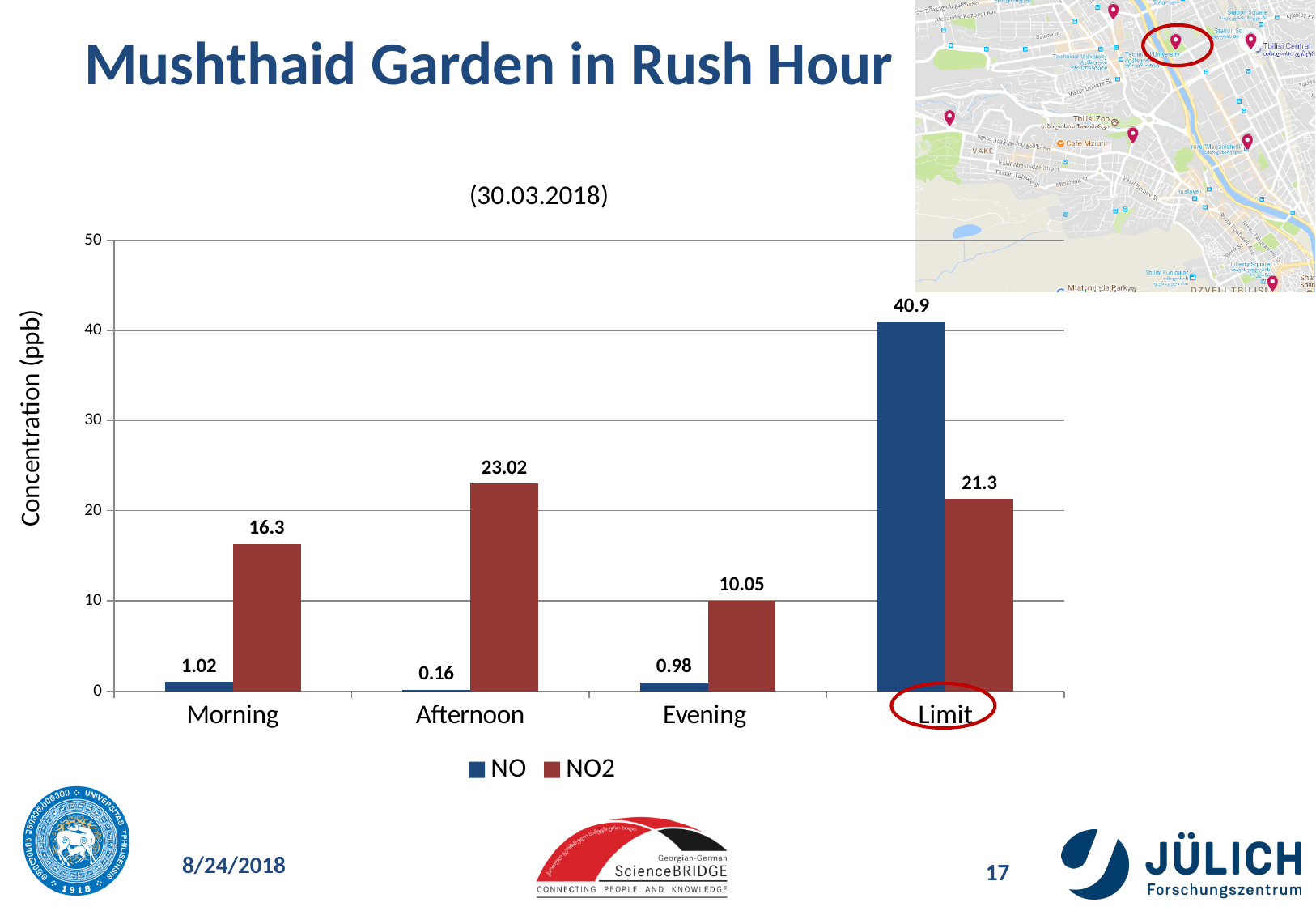
Is the NO2 value for Morning greater or less than 20? less Which category has the lowest NO value? Afternoon How many categories are shown on the x axis? 4 What is the NO concentration in the Morning? 1.02 What kind of chart is shown on the slide? bar chart What is the label of the y axis? Concentration (ppb) What is the difference between the NO2 values for Afternoon and Morning? 6.72 What is the NO2 concentration in the Afternoon? 23.02 How many series does the legend list? 2 What is the NO value for the Limit category? 40.9 Which category has the highest NO2 value? Afternoon Which is larger, the NO2 value for Evening or the NO2 value for Limit? Limit